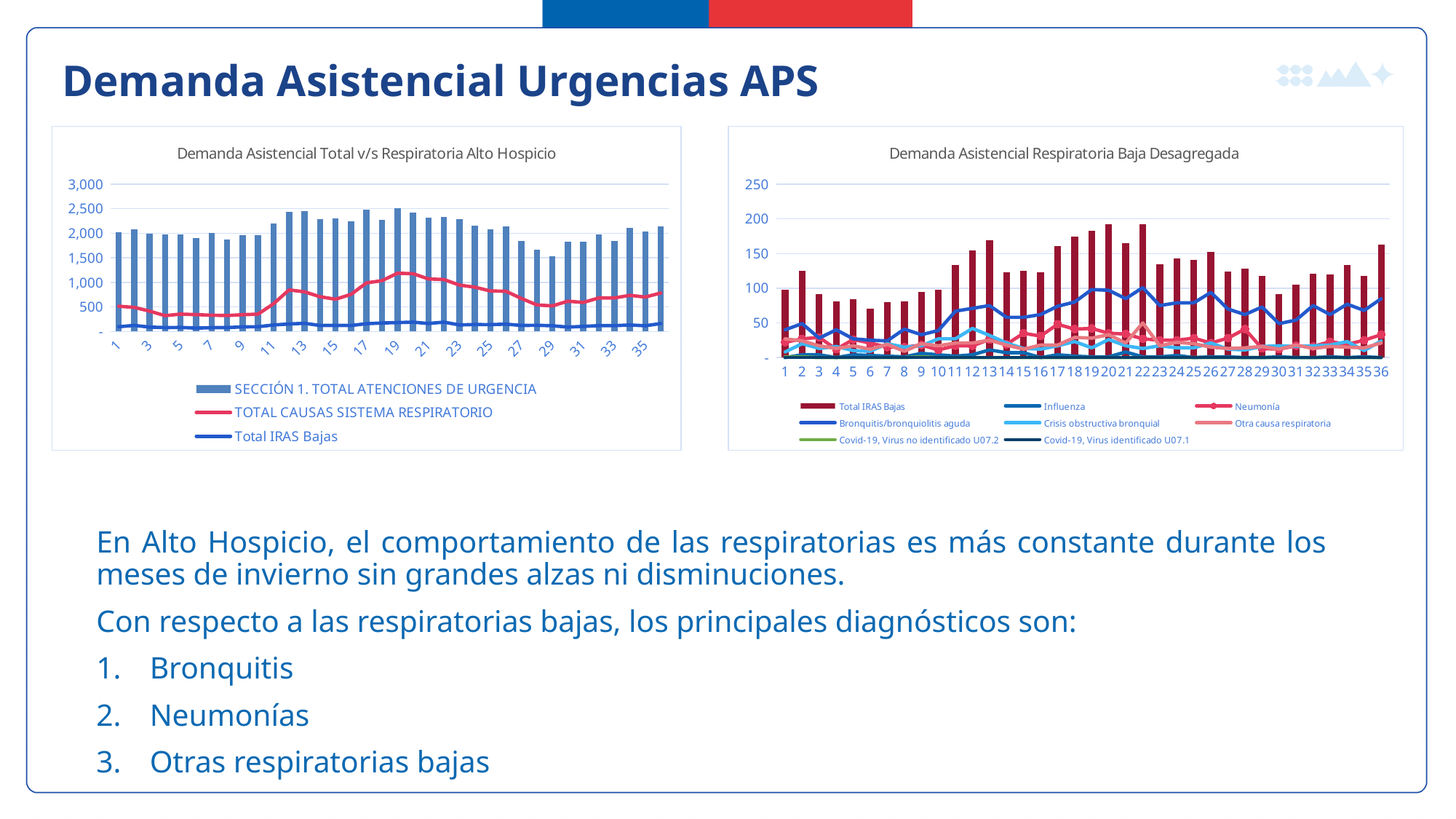
What kind of chart is 'Demanda Asistencial Total v/s Respiratoria Alto Hospicio'? Combined bar and line chart In 'Demanda Asistencial Respiratoria Baja Desagregada', is the Total IRAS Bajas bar for week 6 greater or less than 100? less How many points are plotted along the x axis of 'Demanda Asistencial Respiratoria Baja Desagregada'? 36 In 'Demanda Asistencial Total v/s Respiratoria Alto Hospicio', which series is drawn as a red line? TOTAL CAUSAS SISTEMA RESPIRATORIO In 'Demanda Asistencial Total v/s Respiratoria Alto Hospicio', is the bar for week 1 greater or less than 1,500? greater How many series does the legend of 'Demanda Asistencial Respiratoria Baja Desagregada' list? 8 In 'Demanda Asistencial Total v/s Respiratoria Alto Hospicio', is the bar for week 29 greater or less than 2,000? less In 'Demanda Asistencial Respiratoria Baja Desagregada', which week has the lowest Total IRAS Bajas bar? 6 How many series does the legend of 'Demanda Asistencial Total v/s Respiratoria Alto Hospicio' list? 3 In 'Demanda Asistencial Total v/s Respiratoria Alto Hospicio', which week has the lowest bar for total urgent care attentions? 29 In 'Demanda Asistencial Respiratoria Baja Desagregada', which is larger: the Total IRAS Bajas bar for week 13 or for week 14? Week 13